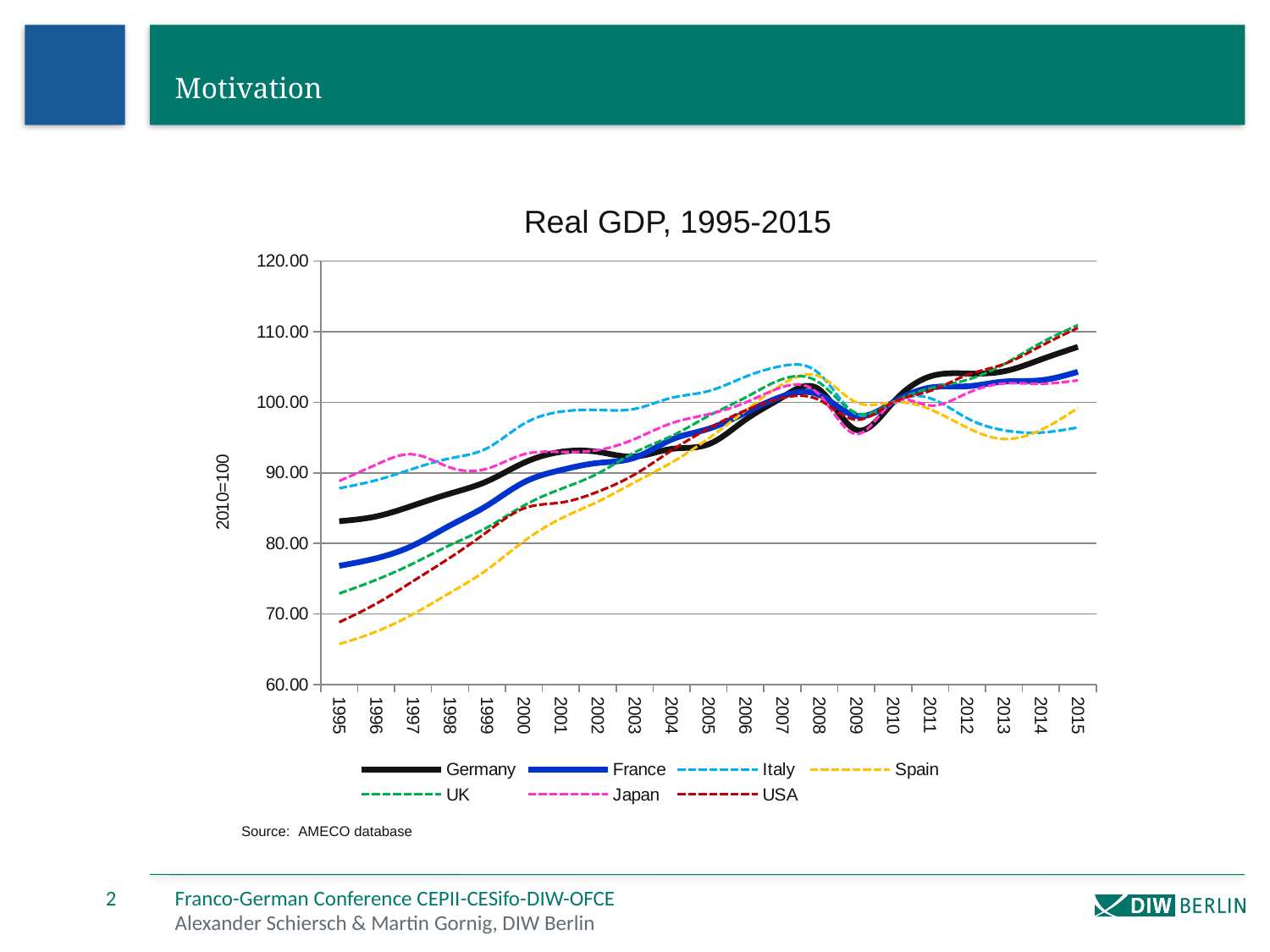
Is the value for Germany in 1995 greater or less than 80? greater Which country has the lowest value in 1995? Spain Does the value for Spain rise or fall from 1995 to 2007? rise How many series does the legend list? 7 What is the title of the chart? Real GDP, 1995-2015 How many years are plotted along the x axis? 21 Is the value for Spain in 1995 greater or less than 70? less What kind of chart is shown on the slide? line chart Is the value for Italy in 2015 greater or less than 100? less In 1995, which is larger, the value for Germany or the value for France? Germany What is the value for Germany in 2010? 100.00 What is the label on the y axis? 2010=100